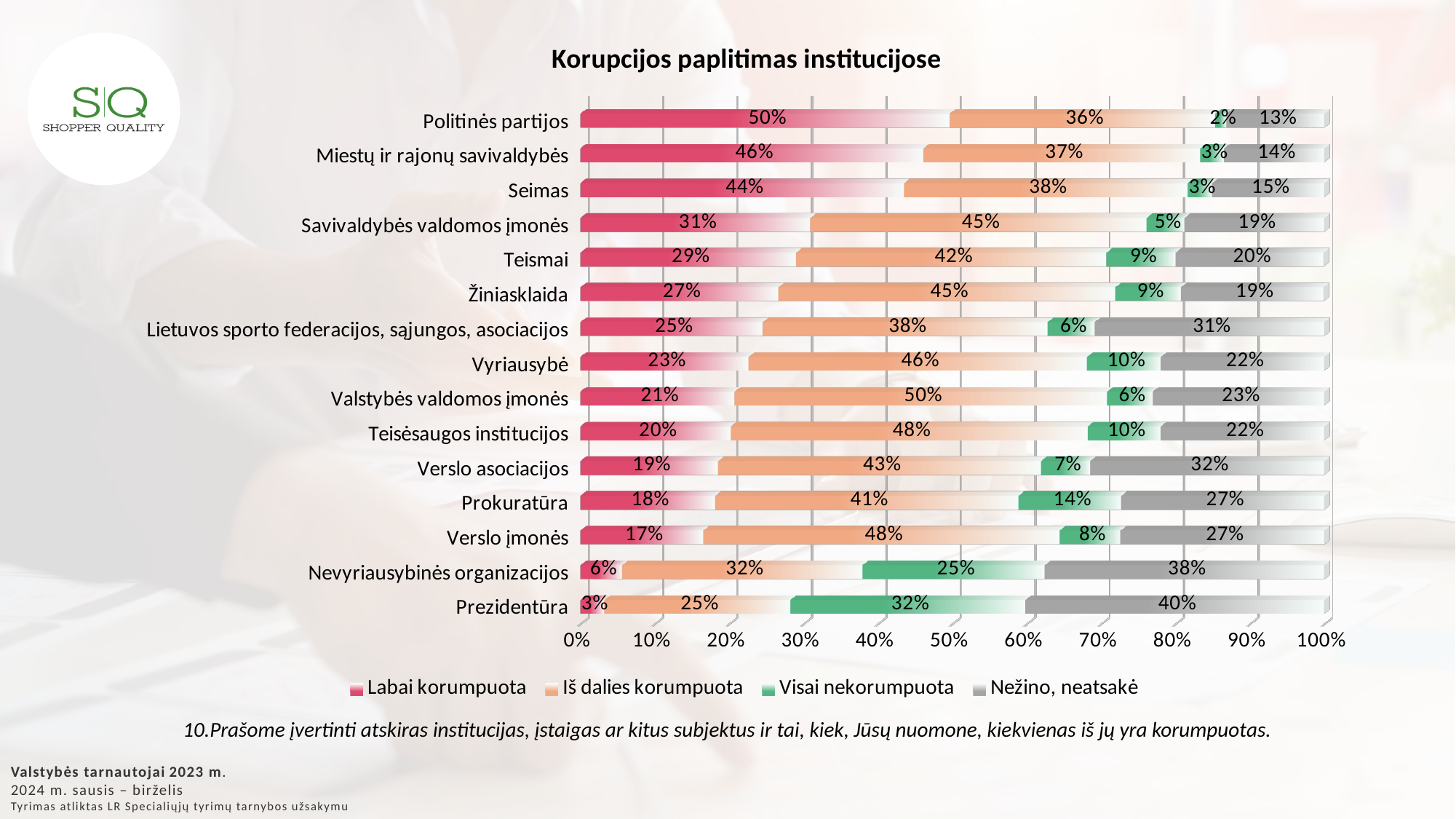
Which institution has the lowest 'Labai korumpuota' value? Prezidentūra Which institution has the highest 'Visai nekorumpuota' value? Prezidentūra What is the 'Labai korumpuota' value for Politinės partijos? 50% What is the total of the stacked bar for Teismai? 100% What is the 'Iš dalies korumpuota' value for Valstybės valdomos įmonės? 50% What is the 'Nežino, neatsakė' value for Prezidentūra? 40% Which is larger: the 'Visai nekorumpuota' value for Prokuratūra or for Verslo įmonės? Prokuratūra How many institutions are listed on the chart? 15 What kind of chart is shown on the slide? Stacked bar chart What is the title of the chart? Korupcijos paplitimas institucijose How many series does the legend list? 4 What is the difference between the 'Labai korumpuota' values for Seimas and Teismai? 15%